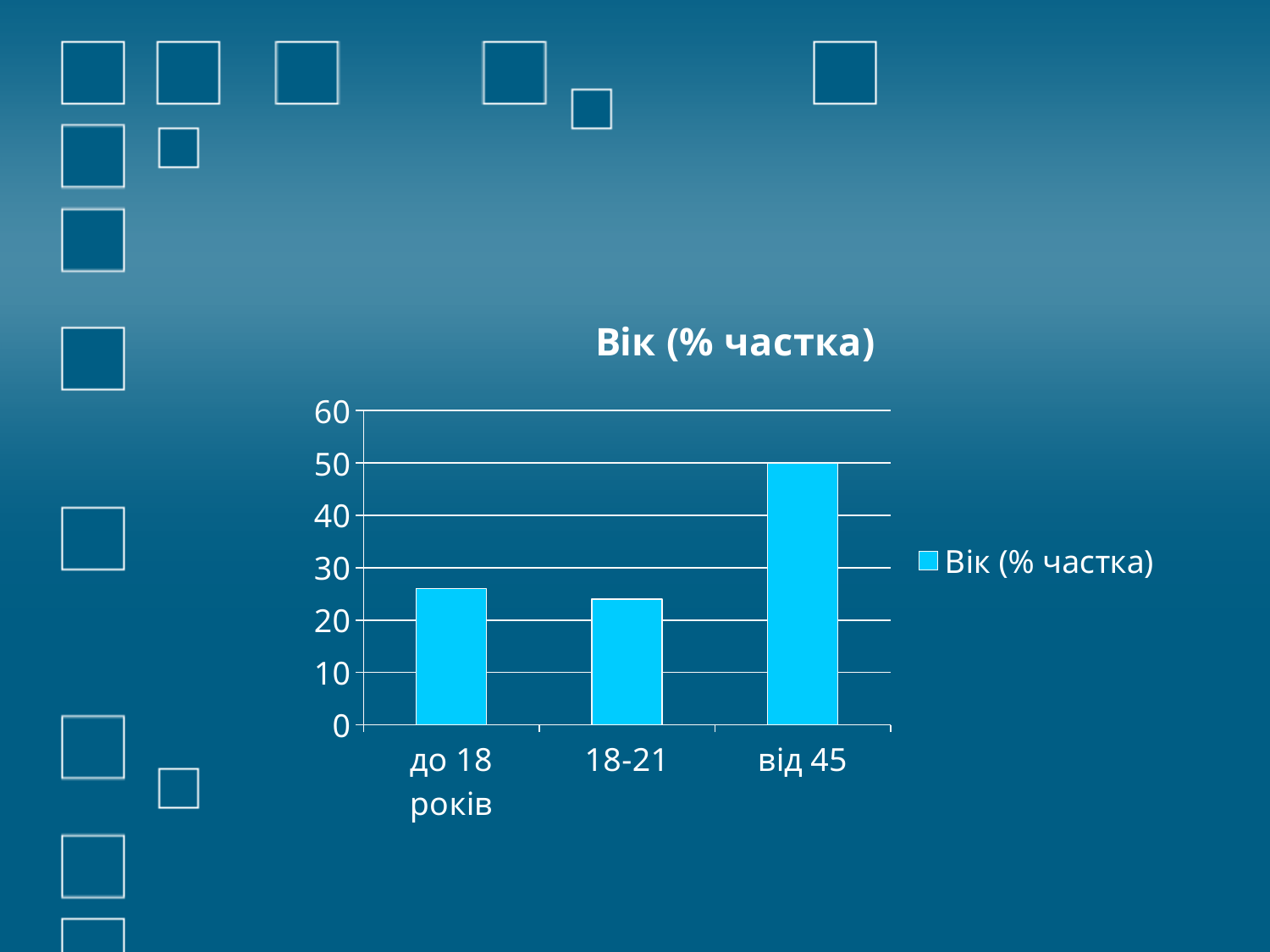
Is the value for 18-21 greater or less than 30? less Is the value for до 18 років greater or less than 30? less How many categories are shown on the x axis? 3 Is the value for до 18 років greater or less than 20? greater What is the title of the chart? Вік (% частка) What is the value for від 45? 50 What is the maximum value shown on the y axis? 60 Which category has the highest value? від 45 Which is larger, the value for 18-21 or the value for від 45? від 45 What kind of chart is this? bar chart How many series does the legend list? 1